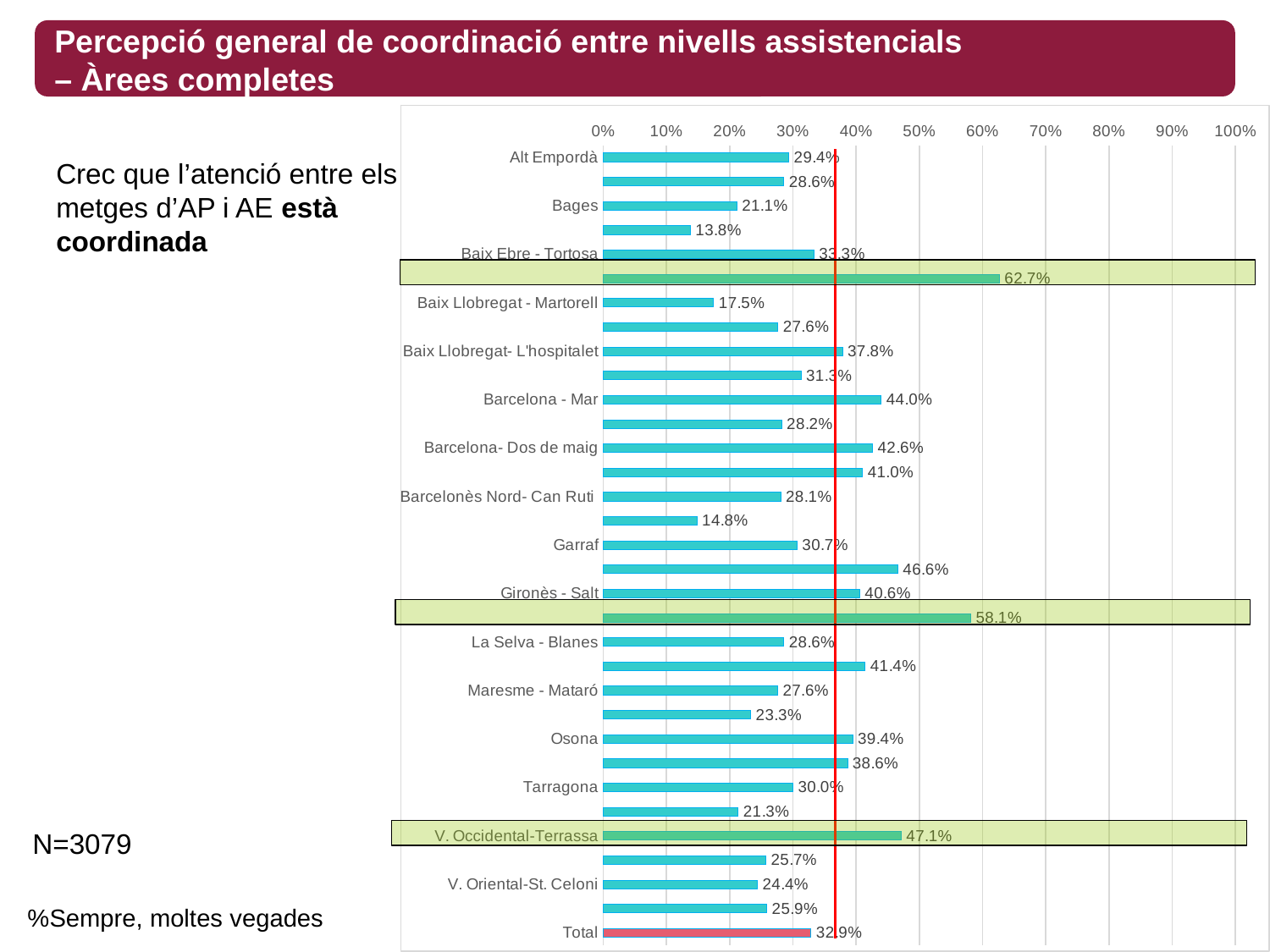
What is the value shown for Bages? 21.1% What is the highest value shown on the x axis? 100% What is the value shown for Total? 32.9% What is the difference between the value for Barcelona - Mar and the value for Bages? 22.9% What is the value shown for V. Occidental-Terrassa? 47.1% What is the title of the slide? Percepció general de coordinació entre nivells assistencials – Àrees completes What is the value shown for Baix Llobregat - Martorell? 17.5% What is the value shown for Alt Empordà? 29.4% Which is larger, the value for Osona or the value for Tarragona? Osona What is the value shown for Barcelona - Mar? 44.0% Is the value for Garraf greater or less than 40%? less What type of chart is shown on the slide? bar chart